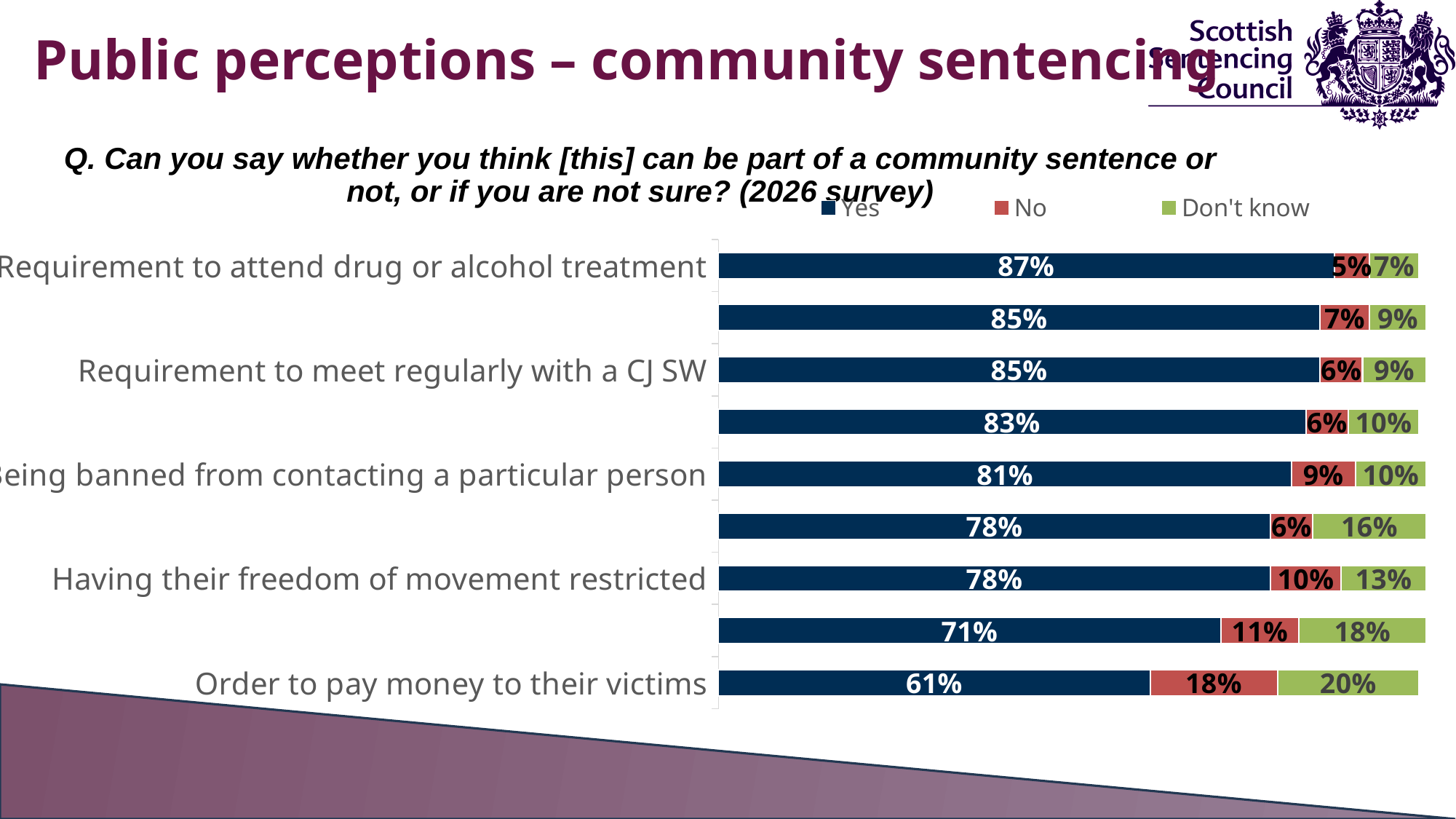
What is the 'Yes' value for 'Having their freedom of movement restricted'? 78% How many series does the legend list? 3 Which labelled category has the lowest 'Yes' value? Order to pay money to their victims How many bars are plotted in the chart? 9 Which legend entry is shown in green? Don't know Which has a larger 'No' value: 'Having their freedom of movement restricted' or 'Requirement to meet regularly with a CJ SW'? Having their freedom of movement restricted What is the 'Yes' value for 'Requirement to attend drug or alcohol treatment'? 87% What is the 'No' value for 'Being banned from contacting a particular person'? 9% Which labelled category has the highest 'Yes' value? Requirement to attend drug or alcohol treatment What is the 'Don't know' value for 'Order to pay money to their victims'? 20% What is the difference between the 'Yes' values for 'Requirement to meet regularly with a CJ SW' and 'Order to pay money to their victims'? 24% What kind of chart is shown on the slide? Stacked bar chart